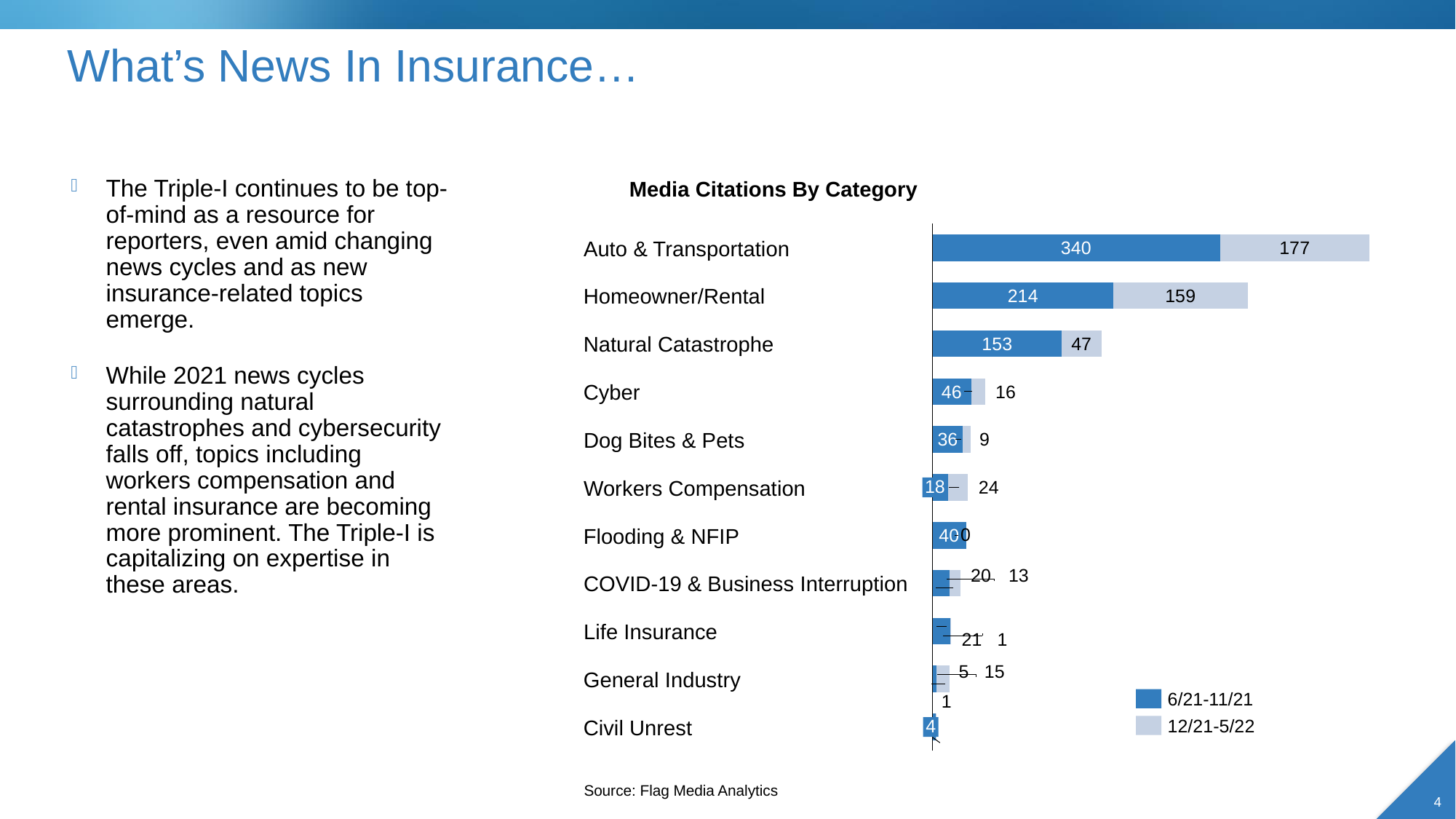
How many series does the chart legend list? 2 What type of chart is shown on the slide? bar chart For Workers Compensation, which is larger: the 6/21-11/21 value or the 12/21-5/22 value? 12/21-5/22 How many categories are shown in the chart? 11 What is the 6/21-11/21 value for Auto & Transportation? 340 What is the 12/21-5/22 value for Natural Catastrophe? 47 What is the difference between the 6/21-11/21 and 12/21-5/22 values for Homeowner/Rental? 55 What is the total of the stacked bar for Auto & Transportation? 517 What is the 12/21-5/22 value for Homeowner/Rental? 159 Which category has the highest 6/21-11/21 value? Auto & Transportation What is the 6/21-11/21 value for Cyber? 46 What is the title of the chart? Media Citations By Category